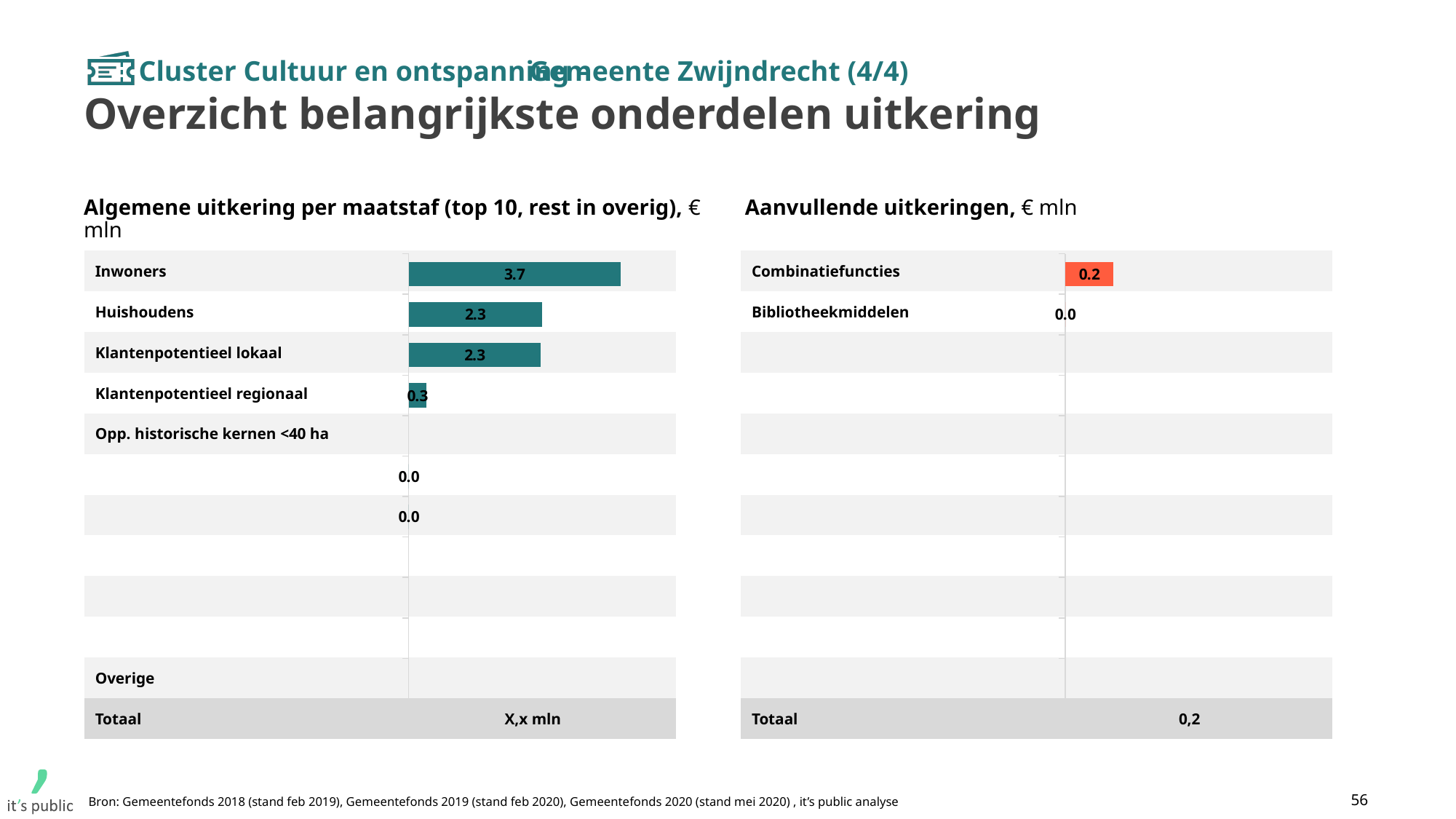
In the chart 'Aanvullende uitkeringen', what is the value for Bibliotheekmiddelen? 0.0 What kind of chart is the chart 'Algemene uitkering per maatstaf'? Bar chart In the chart 'Aanvullende uitkeringen', what is the total shown in the Totaal row? 0,2 In the chart 'Algemene uitkering per maatstaf', which category has the highest value? Inwoners In the chart 'Aanvullende uitkeringen', which category has the lowest value? Bibliotheekmiddelen In the chart 'Algemene uitkering per maatstaf', what is the value for Inwoners? 3.7 In the chart 'Algemene uitkering per maatstaf', which is larger: the value for Klantenpotentieel lokaal or Klantenpotentieel regionaal? Klantenpotentieel lokaal In the chart 'Algemene uitkering per maatstaf', what is the difference between the values for Inwoners and Huishoudens? 1.4 In the chart 'Aanvullende uitkeringen', what is the value for Combinatiefuncties? 0.2 In the chart 'Algemene uitkering per maatstaf', what is the value for Huishoudens? 2.3 In what unit are the values in the chart 'Aanvullende uitkeringen' expressed? € mln In the chart 'Algemene uitkering per maatstaf', what is the value for Klantenpotentieel regionaal? 0.3